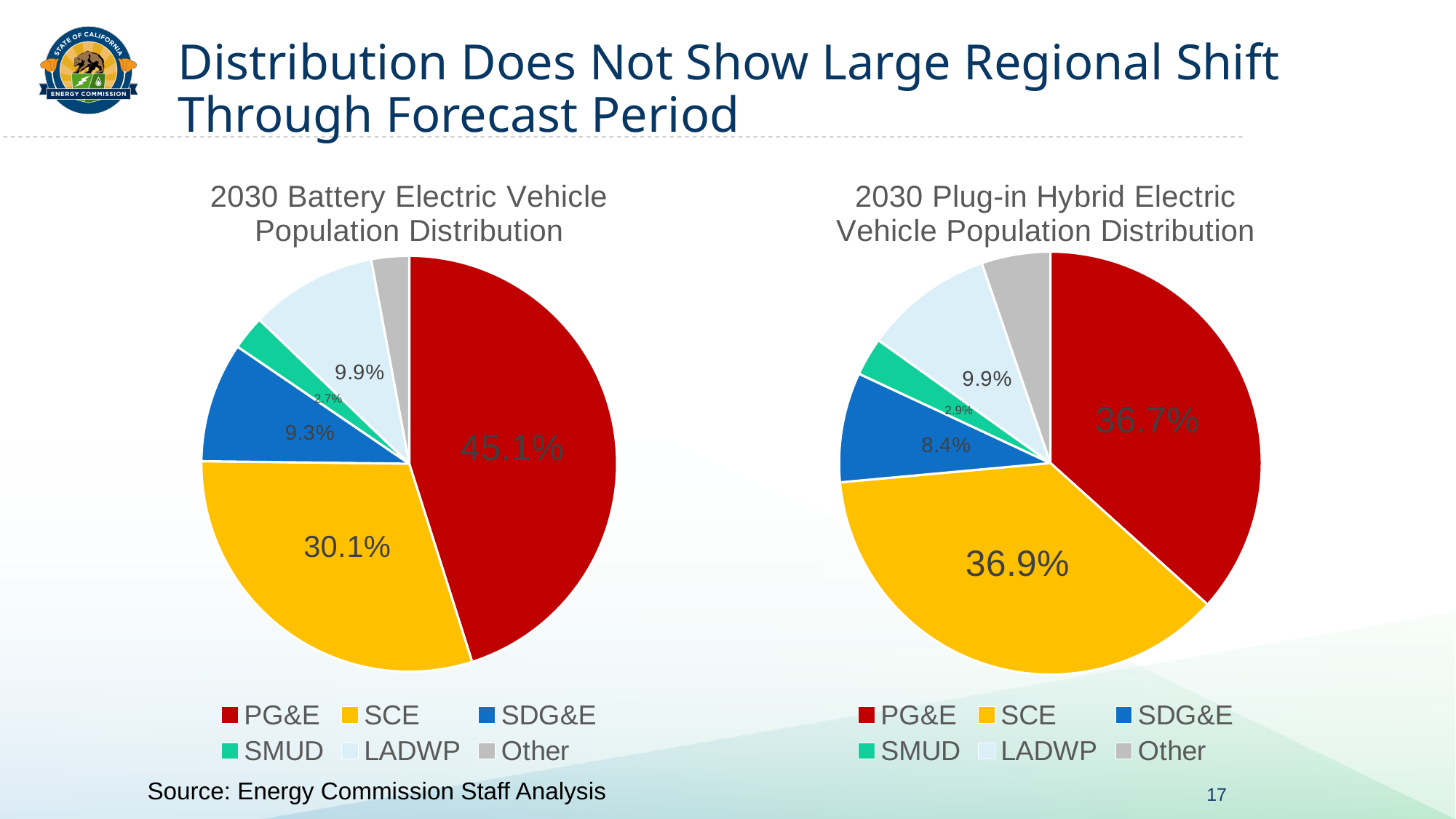
In the 2030 Battery Electric Vehicle Population Distribution chart, what share does SMUD have? 2.7% How many categories are shown in the 2030 Plug-in Hybrid Electric Vehicle Population Distribution pie chart? 6 In the 2030 Plug-in Hybrid Electric Vehicle Population Distribution chart, what share does SDG&E have? 8.4% In the 2030 Battery Electric Vehicle Population Distribution chart, which utility has the largest slice? PG&E In the 2030 Battery Electric Vehicle Population Distribution chart, which is larger, the SDG&E slice or the LADWP slice? LADWP In the 2030 Plug-in Hybrid Electric Vehicle Population Distribution chart, what is the difference between SCE's share and PG&E's share? 0.2% In the 2030 Plug-in Hybrid Electric Vehicle Population Distribution chart, which utility has the smallest slice? SMUD In the 2030 Plug-in Hybrid Electric Vehicle Population Distribution chart, what share does SCE have? 36.9% How many entries does the legend of the 2030 Battery Electric Vehicle Population Distribution chart list? 6 In the 2030 Battery Electric Vehicle Population Distribution chart, how many percentage points larger is PG&E's share than SCE's share? 15.0% In the 2030 Battery Electric Vehicle Population Distribution chart, what share does PG&E have? 45.1% What kind of chart is the 2030 Battery Electric Vehicle Population Distribution chart? Pie chart